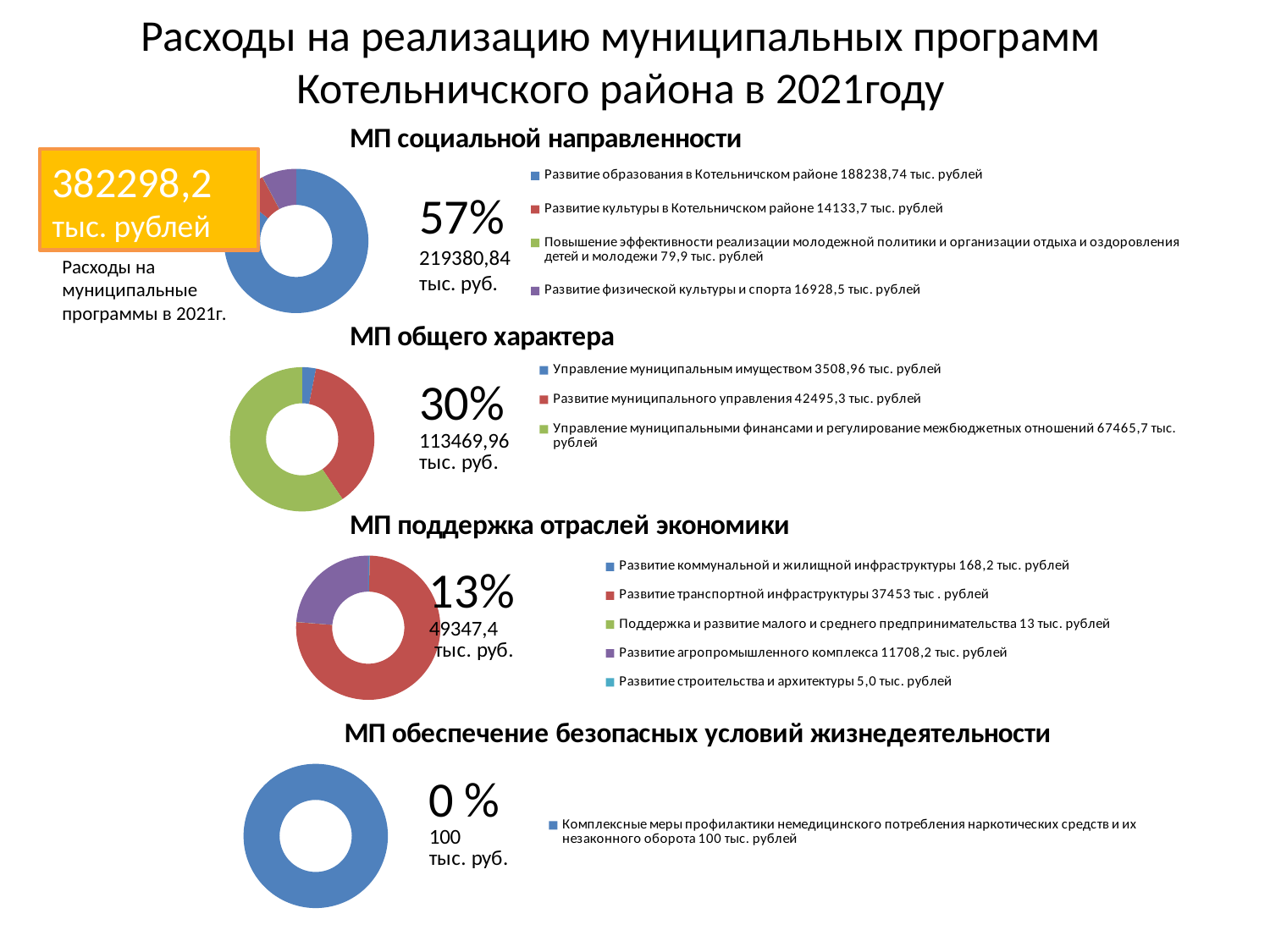
In the "МП поддержка отраслей экономики" chart, which is larger: "Развитие транспортной инфраструктуры" or "Развитие агропромышленного комплекса"? Развитие транспортной инфраструктуры In the "МП общего характера" chart, which category has the highest value? Управление муниципальными финансами и регулирование межбюджетных отношений In the "МП социальной направленности" chart, which category has the lowest value? Повышение эффективности реализации молодежной политики и организации отдыха и оздоровления детей и молодежи In the "МП социальной направленности" chart, what is the difference between "Развитие физической культуры и спорта" and "Развитие культуры в Котельничском районе"? 2794,8 тыс. рублей In the "МП поддержка отраслей экономики" chart, how many categories does the legend list? 5 In the "МП обеспечение безопасных условий жизнедеятельности" chart, what is the value for "Комплексные меры профилактики немедицинского потребления наркотических средств и их незаконного оборота"? 100 тыс. рублей In the "МП социальной направленности" chart, what is the value for "Развитие образования в Котельничском районе"? 188238,74 тыс. рублей What percentage share is shown for the "МП поддержка отраслей экономики" chart? 13% What total amount is shown next to the "МП общего характера" chart? 113469,96 тыс. руб. What kind of chart is used for "МП социальной направленности"? Doughnut (pie) chart In the "МП социальной направленности" chart, how many categories does the legend list? 4 In the "МП общего характера" chart, what is the value for "Управление муниципальным имуществом"? 3508,96 тыс. рублей